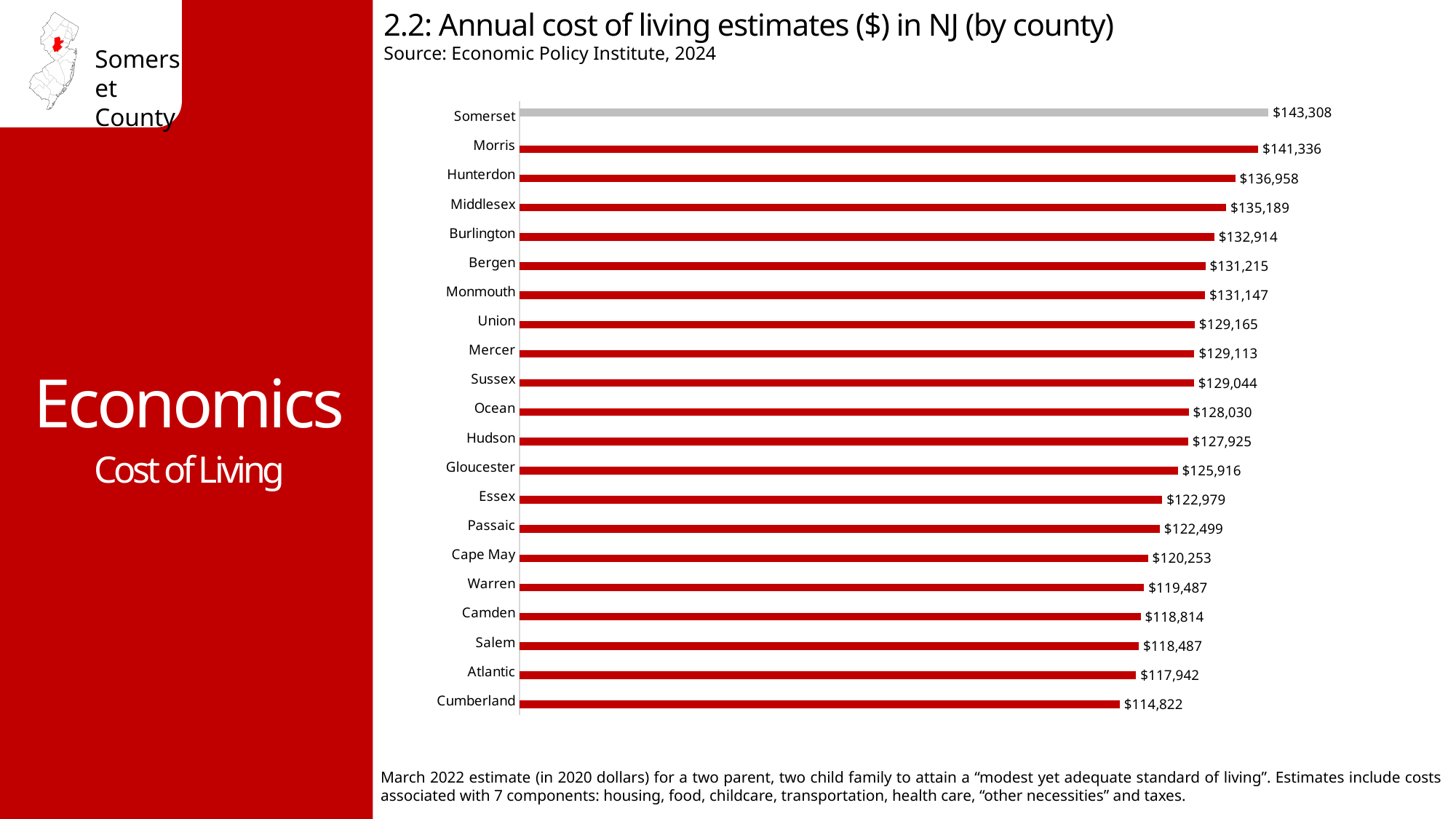
What is the difference between the cost of living estimates for Somerset and Cumberland? $28,486 What is the annual cost of living estimate for Hudson County? $127,925 What is the annual cost of living estimate for Cape May County? $120,253 Which county has a higher cost of living estimate, Warren or Middlesex? Middlesex How many counties are shown in the chart? 21 What is the difference between the cost of living estimates for Morris and Hunterdon? $4,378 What is the annual cost of living estimate for Somerset County? $143,308 Which county has the lowest annual cost of living estimate? Cumberland Which county's bar is shown in a different colour (grey) from the others? Somerset What type of chart is used to show the cost of living estimates? Bar chart Which county has a higher cost of living estimate, Bergen or Essex? Bergen Which county has the highest annual cost of living estimate? Somerset